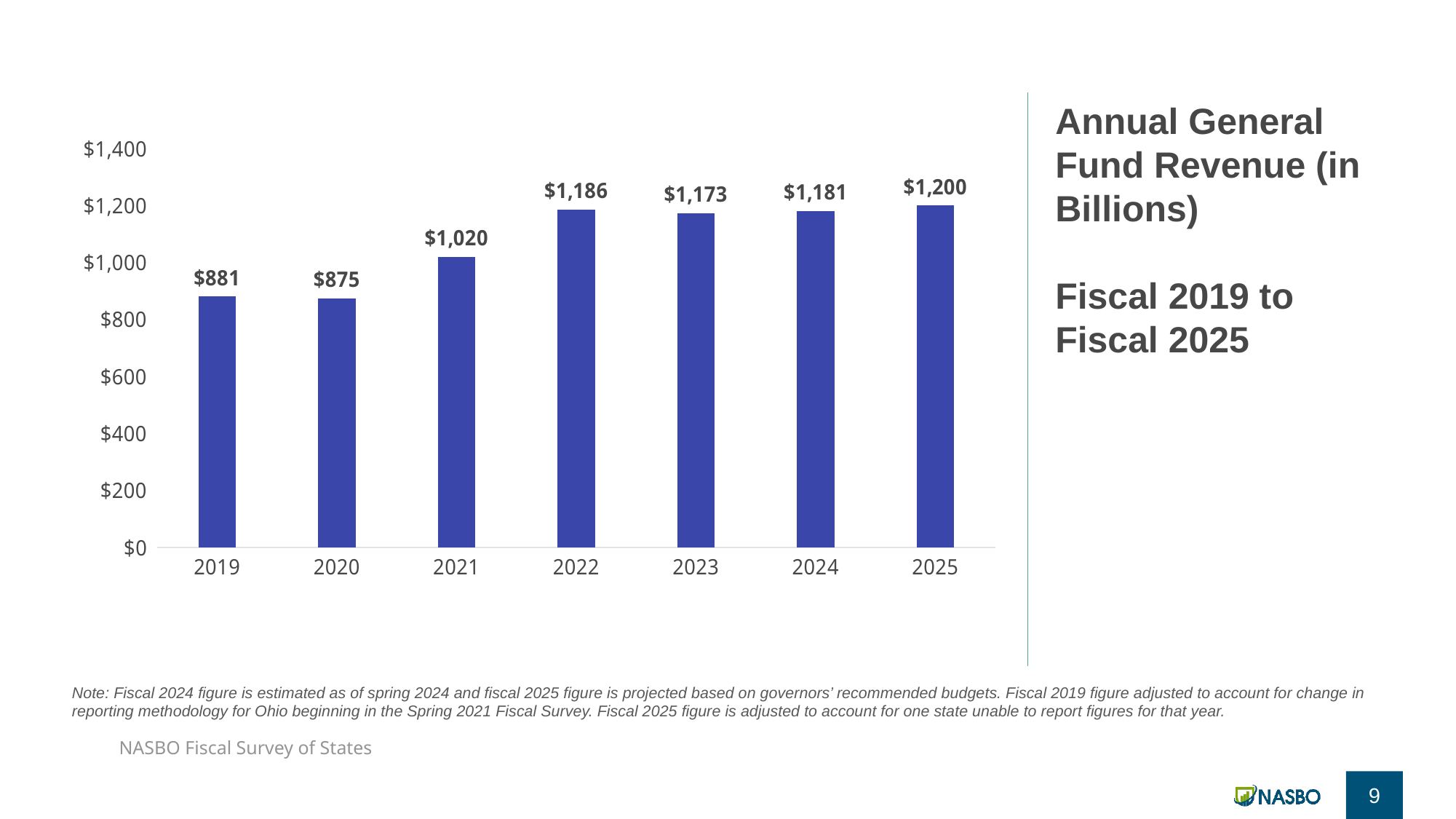
Is the value for fiscal 2020 greater or less than $1,000? less Which fiscal year has the lowest general fund revenue? 2020 How many fiscal years are shown on the chart? 7 Which is larger, the general fund revenue for fiscal 2022 or fiscal 2024? 2022 What is the difference between the fiscal 2025 and fiscal 2024 general fund revenue values? $19 What kind of chart is shown on the slide? bar chart Which fiscal year has the highest general fund revenue? 2025 What is the difference between the fiscal 2022 and fiscal 2019 general fund revenue values? $305 Do the general fund revenue values generally rise or fall from fiscal 2019 to fiscal 2025? rise What is the annual general fund revenue for fiscal 2021? $1,020 What is the title of the chart? Annual General Fund Revenue (in Billions) Fiscal 2019 to Fiscal 2025 What is the annual general fund revenue for fiscal 2023? $1,173